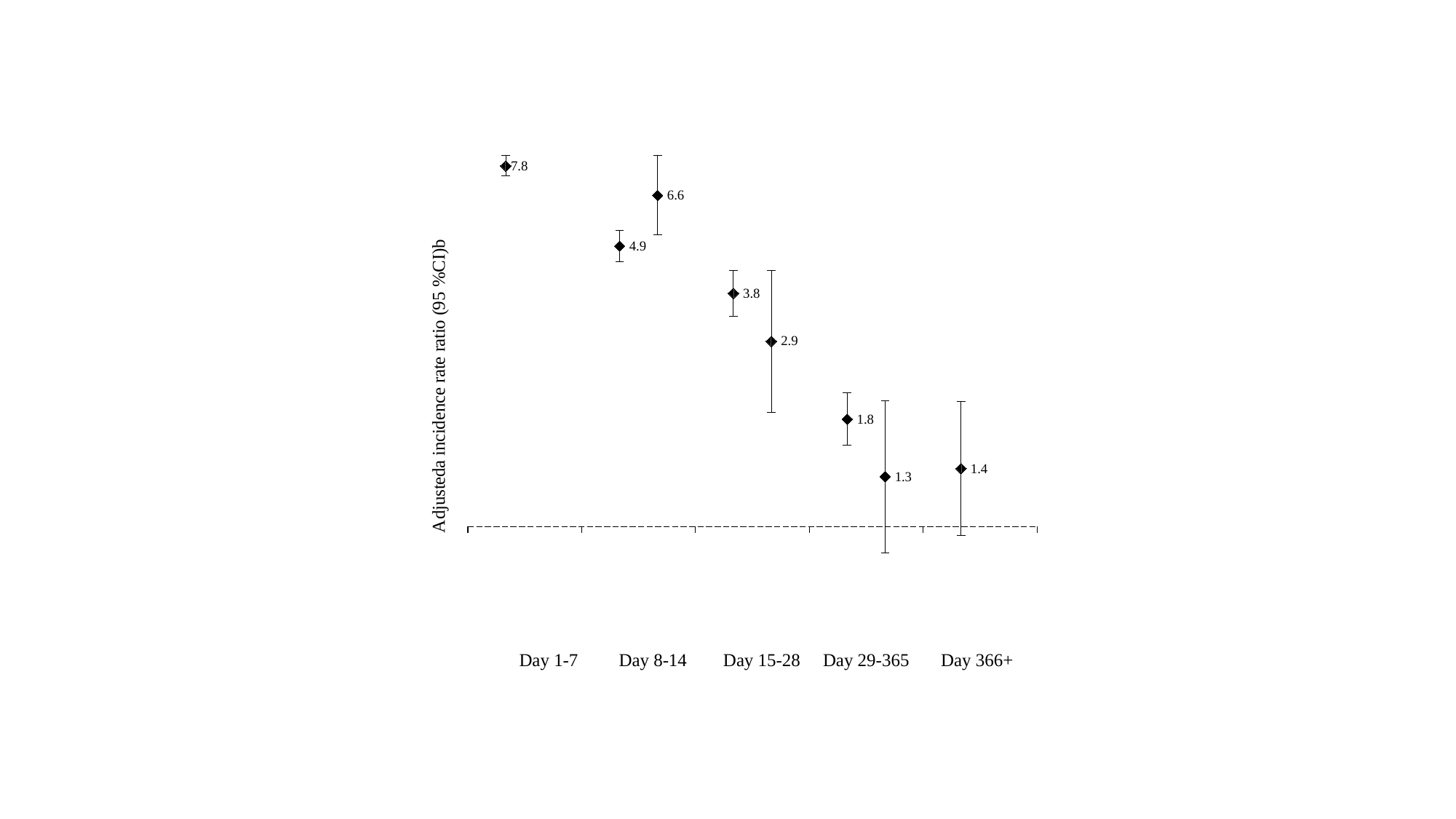
What is the label on the y axis? Adjusteda incidence rate ratio (95 %CI)b How many categories are shown on the x axis? 5 Which x-axis category contains the highest plotted value? Day 1-7 What is the lowest value labelled on the chart? 1.3 What is the difference between the value for Day 1-7 and the value for Day 366+? 6.4 What is the adjusted incidence rate ratio plotted for Day 1-7? 7.8 Which is larger, the value for Day 1-7 or the value for Day 366+? Day 1-7 What is the value of the right-hand point in the Day 8-14 category? 6.6 What is the value of the left-hand point in the Day 8-14 category? 4.9 What is the adjusted incidence rate ratio plotted for Day 366+? 1.4 Do the plotted values generally rise or fall from Day 1-7 to Day 366+? fall What is the difference between the two values plotted in the Day 8-14 category (6.6 and 4.9)? 1.7